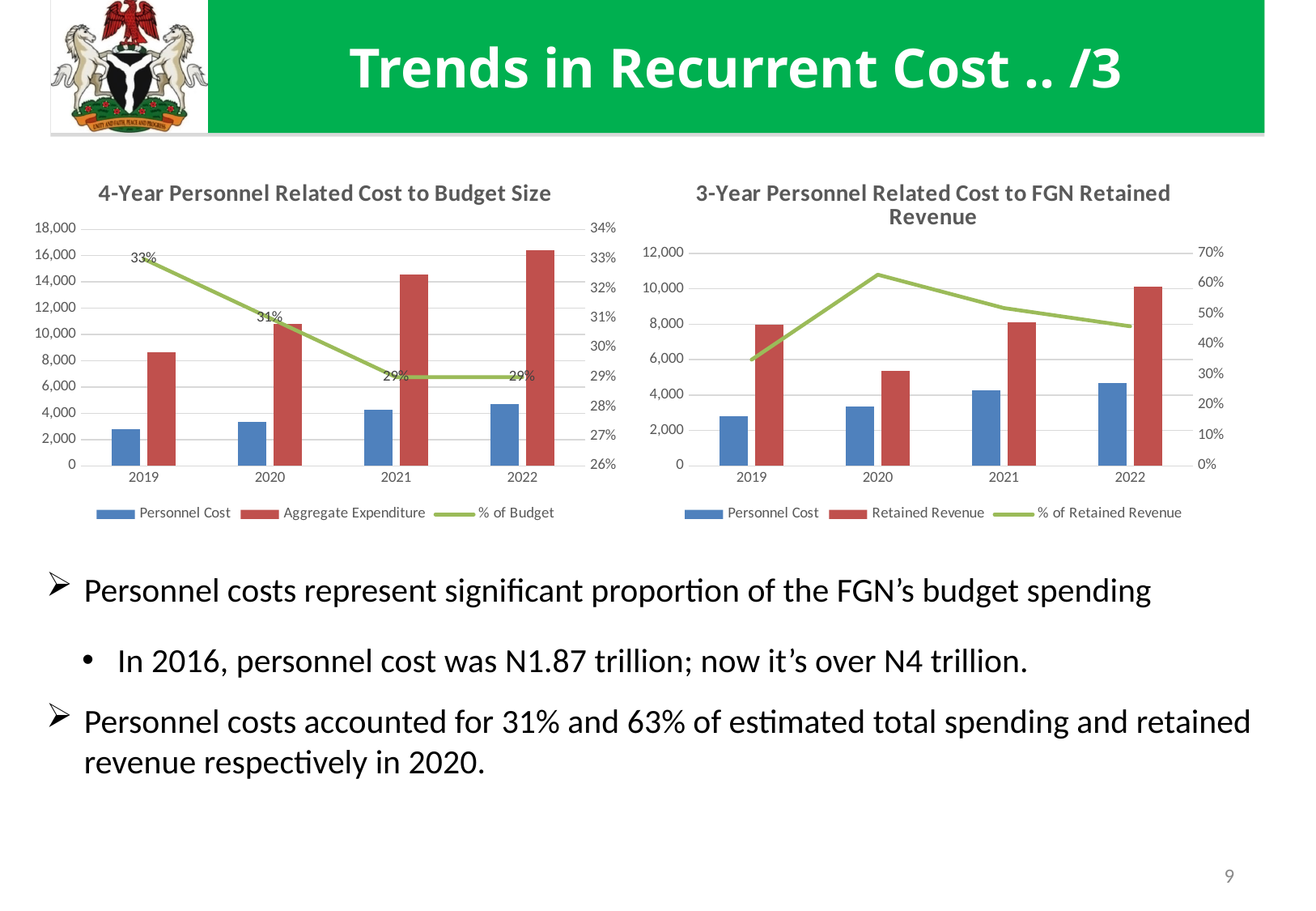
In the '3-Year Personnel Related Cost to FGN Retained Revenue' chart, is the Retained Revenue for 2020 greater or less than 6,000? less How many series does the legend of the '3-Year Personnel Related Cost to FGN Retained Revenue' chart list? 3 In the '3-Year Personnel Related Cost to FGN Retained Revenue' chart, which year has the highest % of Retained Revenue? 2020 In the '4-Year Personnel Related Cost to Budget Size' chart, which year has the lowest Personnel Cost? 2019 In the '4-Year Personnel Related Cost to Budget Size' chart, what is the % of Budget value for 2021? 29% In the '4-Year Personnel Related Cost to Budget Size' chart, is the Aggregate Expenditure for 2022 greater or less than 14,000? greater In the '4-Year Personnel Related Cost to Budget Size' chart, which year has the highest Aggregate Expenditure? 2022 In the '4-Year Personnel Related Cost to Budget Size' chart, does the % of Budget line rise or fall from 2019 to 2022? fall In the '4-Year Personnel Related Cost to Budget Size' chart, by how many percentage points did the % of Budget fall from 2019 to 2020? 2 percentage points In the '3-Year Personnel Related Cost to FGN Retained Revenue' chart, which is larger: Retained Revenue in 2021 or in 2022? 2022 In the '4-Year Personnel Related Cost to Budget Size' chart, what is the % of Budget value for 2020? 31% In the '4-Year Personnel Related Cost to Budget Size' chart, what is the % of Budget value for 2019? 33%